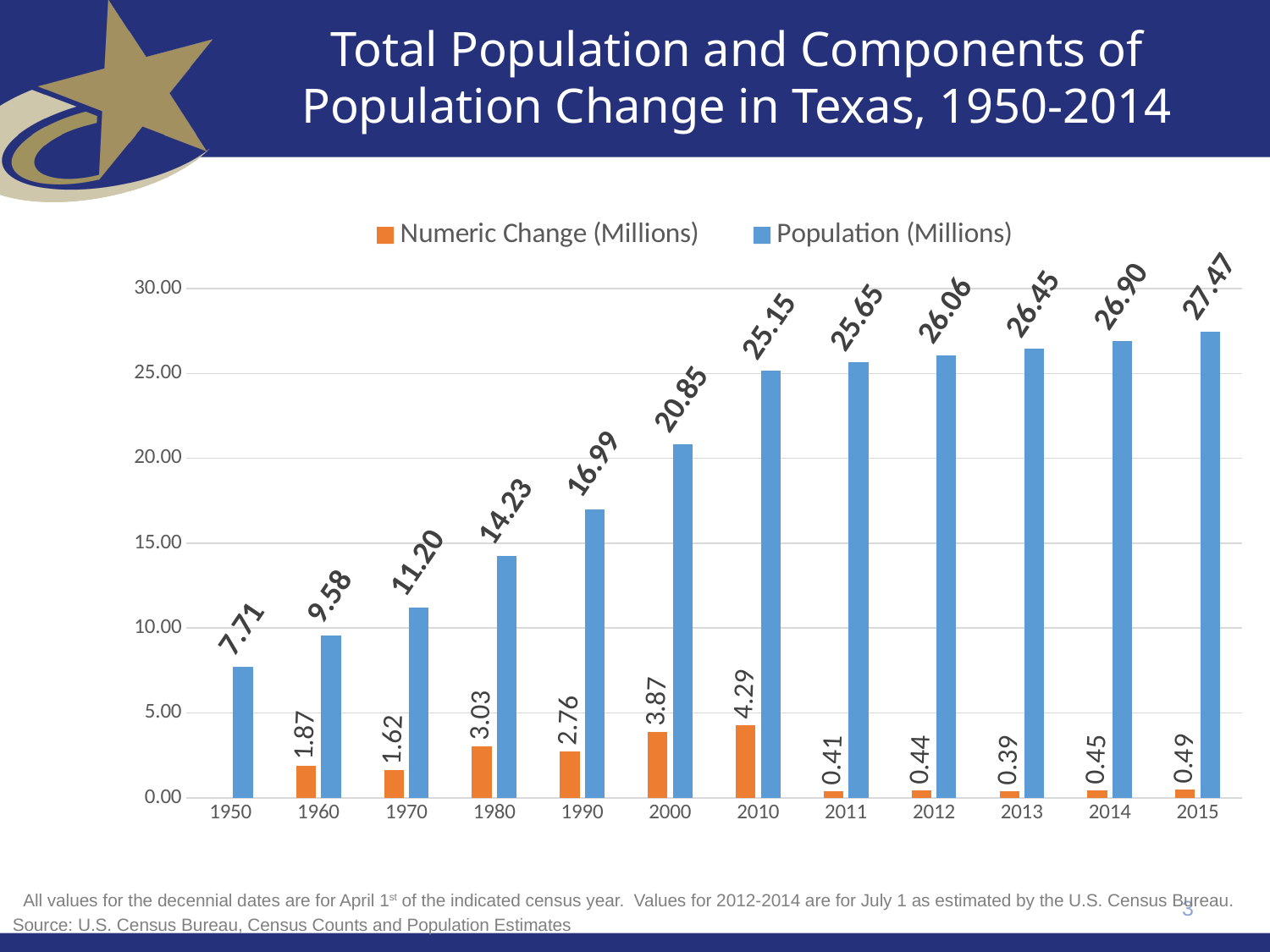
What is the Numeric Change (Millions) value for 2010? 4.29 Which year has the lowest Numeric Change (Millions) value? 2013 What colour are the Numeric Change (Millions) bars? orange Is the Population (Millions) value for 1990 greater or less than 15.00? greater Which year has the larger Numeric Change (Millions) value, 1980 or 1990? 1980 What is the difference between the Population (Millions) values for 2015 and 2010? 2.32 What is the Population (Millions) value for 2000? 20.85 How many series does the legend list? 2 What kind of chart is shown on the slide? bar chart Does the Population (Millions) series rise or fall from 1950 to 2015? rise How many years are shown on the x axis of the chart? 12 Which year has the highest Population (Millions) value? 2015